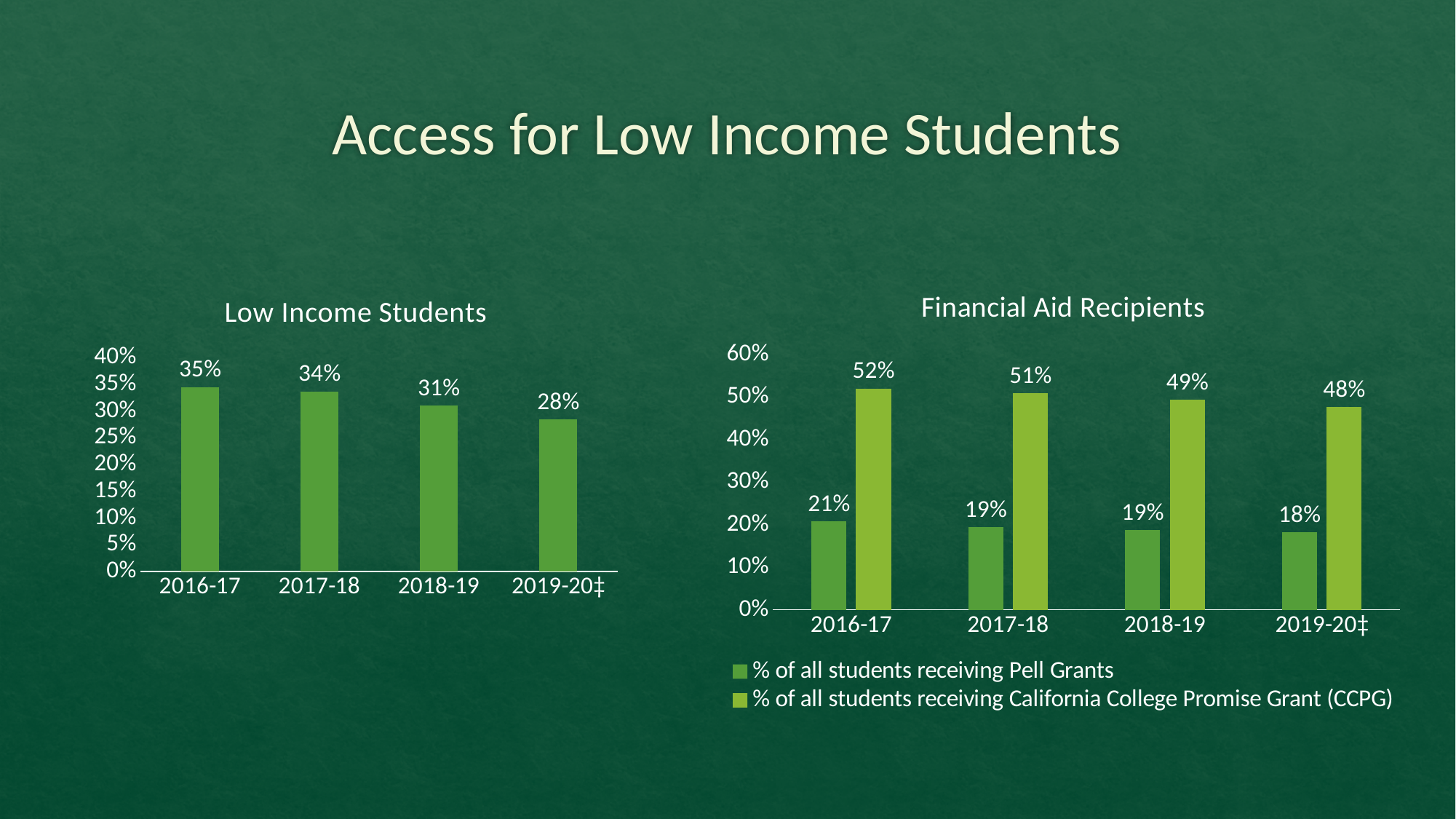
How many series does the legend of the 'Financial Aid Recipients' chart list? 2 In the 'Low Income Students' chart, how many years are shown? 4 In the 'Low Income Students' chart, what is the value for 2016-17? 35% What kind of chart is the 'Financial Aid Recipients' chart? bar chart In the 'Low Income Students' chart, which year has the lowest value? 2019-20‡ In the 'Financial Aid Recipients' chart, what percentage of all students received the California College Promise Grant (CCPG) in 2018-19? 49% In the 'Financial Aid Recipients' chart, which is larger in 2019-20‡: the Pell Grants value or the CCPG value? CCPG In the 'Financial Aid Recipients' chart, what is the difference between the CCPG and Pell Grant values in 2016-17? 31% In the 'Financial Aid Recipients' chart, which year has the highest CCPG value? 2016-17 In the 'Low Income Students' chart, what is the difference between the 2016-17 and 2019-20‡ values? 7% In the 'Financial Aid Recipients' chart, what percentage of all students received Pell Grants in 2017-18? 19% In the 'Low Income Students' chart, do the values rise or fall from 2016-17 to 2019-20‡? fall